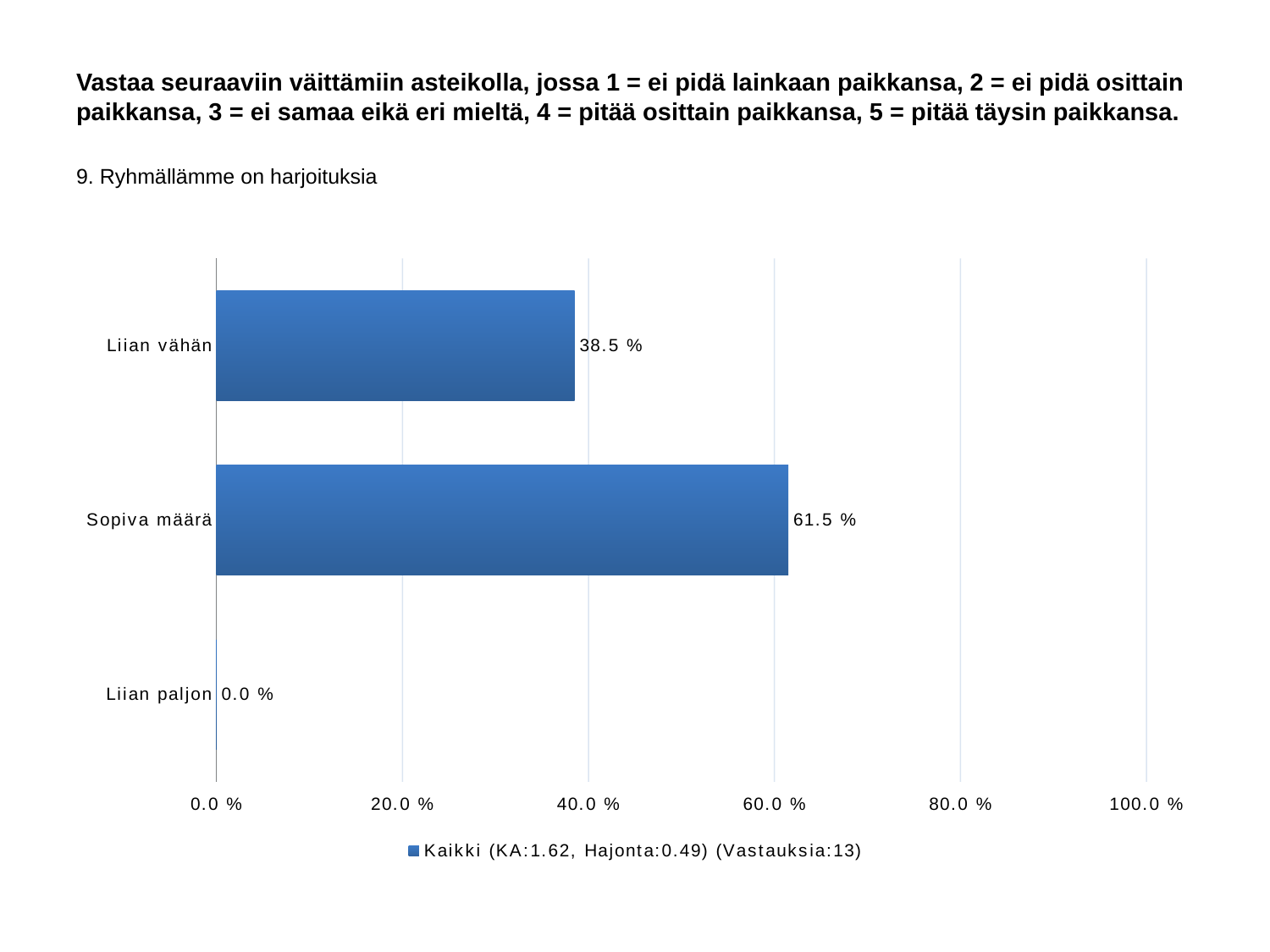
Which category has the highest value? Sopiva määrä Which is larger, the value for Liian vähän or the value for Sopiva määrä? Sopiva määrä How many responses (Vastauksia) does the legend report? 13 Is the value for Liian vähän greater or less than 40.0 %? less What is the value for Sopiva määrä? 61.5 % Is the value for Sopiva määrä greater or less than 60.0 %? greater What is the value for Liian vähän? 38.5 % What is the difference between the values for Sopiva määrä and Liian vähän? 23.0 % Which category has the lowest value? Liian paljon What is the value for Liian paljon? 0.0 % How many categories are shown on the chart? 3 What kind of chart is shown on the slide? Bar chart